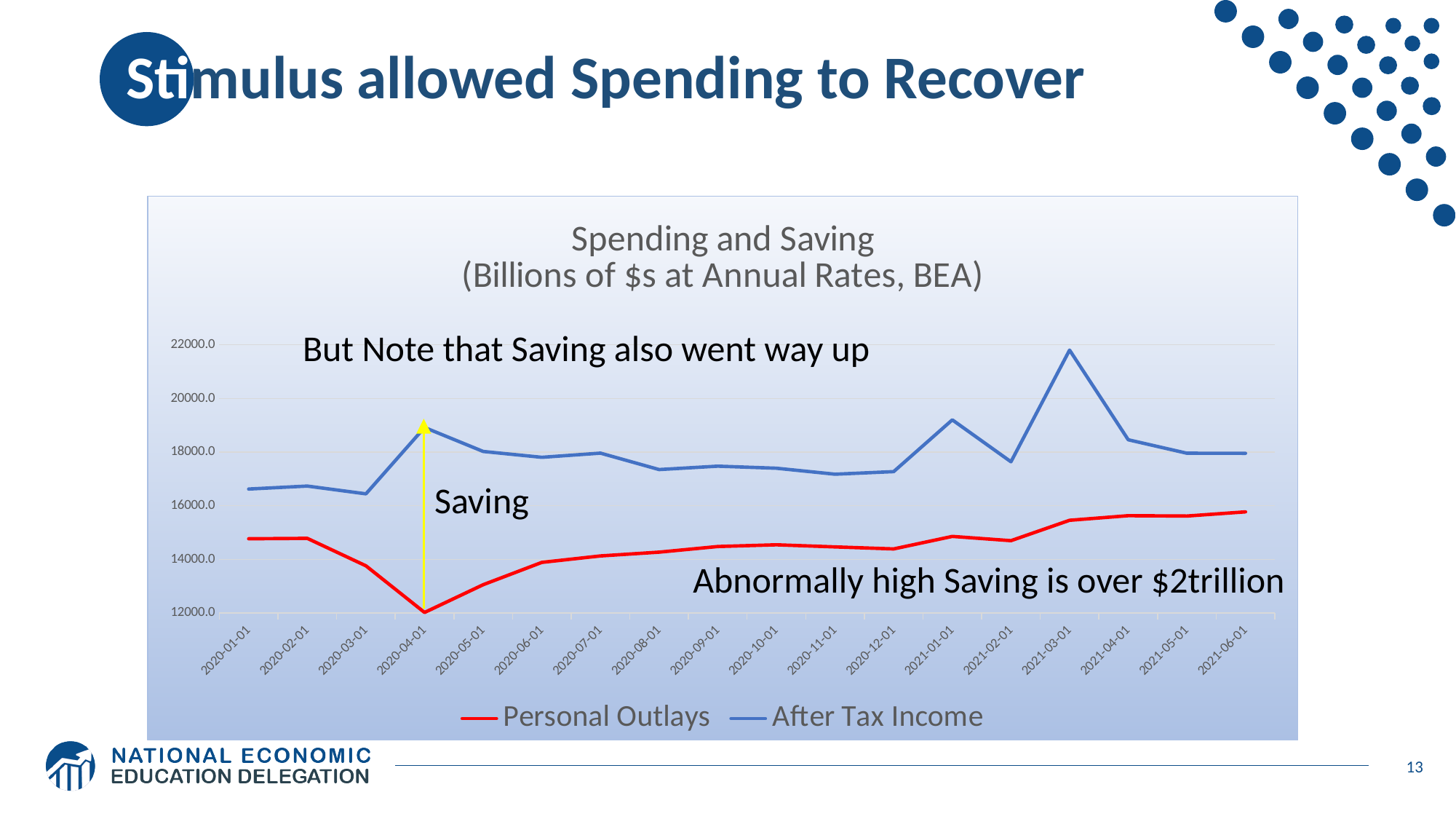
How many series does the chart legend list? 2 Is the value of Personal Outlays at 2020-04-01 greater or less than 14000.0? less At 2020-04-01, which series has the higher value, Personal Outlays or After Tax Income? After Tax Income Is the value of After Tax Income at 2021-03-01 greater or less than 20000.0? greater What kind of chart is shown on the slide? Line chart Which series is drawn in red? Personal Outlays Does Personal Outlays rise or fall from 2020-04-01 to 2021-06-01? Rise Is the value of After Tax Income at 2020-11-01 greater or less than 18000.0? less At which date does After Tax Income reach its highest value? 2021-03-01 How many dates are shown along the x axis? 18 At which date does Personal Outlays reach its lowest value? 2020-04-01 What is the title of the chart? Spending and Saving (Billions of $s at Annual Rates, BEA)